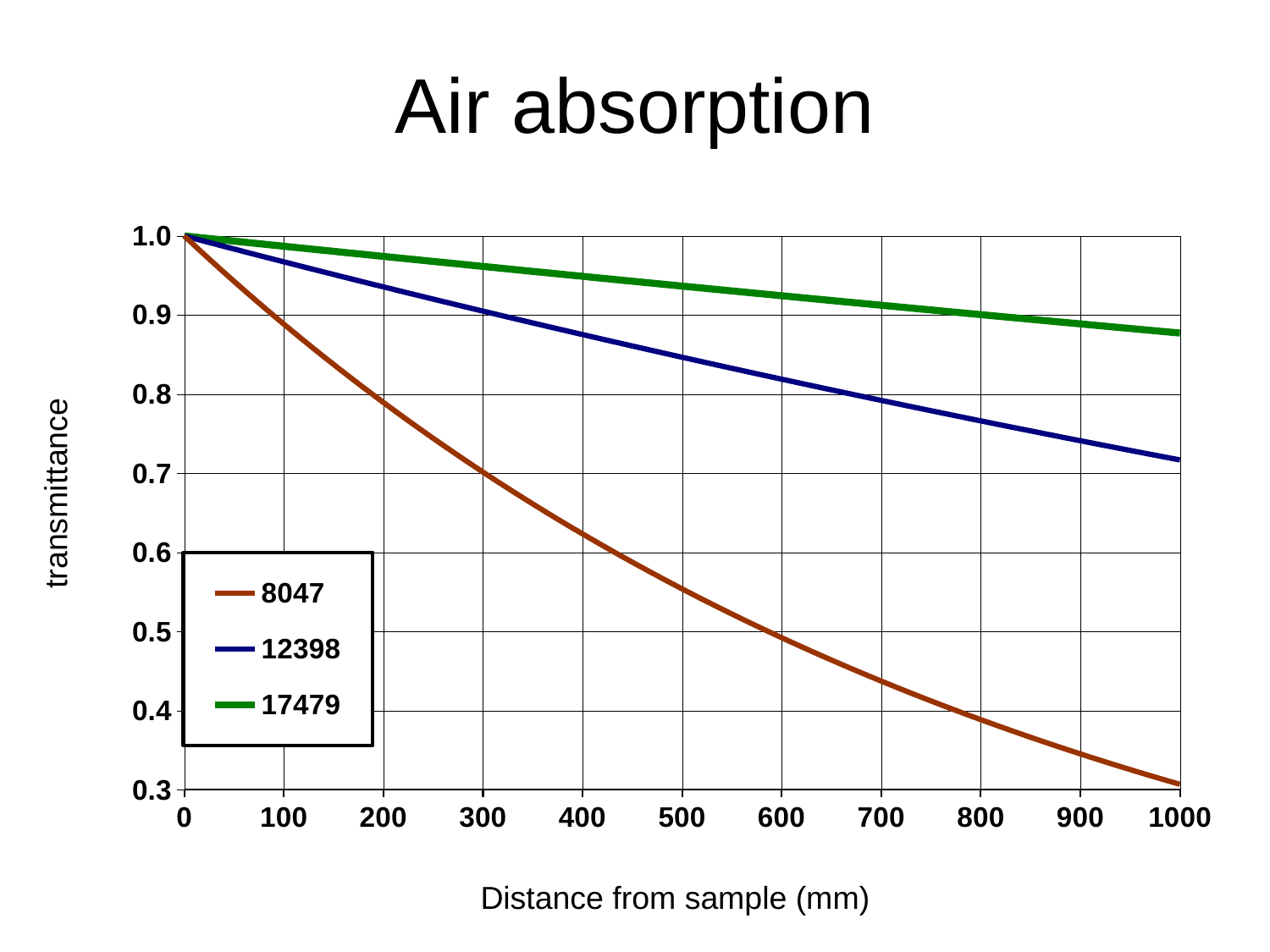
Which series has the highest transmittance at 1000 mm? 17479 Is the transmittance for series 17479 at 1000 mm greater or less than 0.9? less What is the label of the y axis? transmittance What kind of chart is shown on the slide? line chart Is the transmittance for series 8047 at 500 mm greater or less than 0.6? less Does the transmittance for series 8047 rise or fall as distance from sample increases? fall Is the transmittance for series 12398 at 1000 mm greater or less than 0.7? greater How many series does the legend list? 3 Which series has the lowest transmittance at 1000 mm? 8047 What is the title of the chart? Air absorption At 600 mm, which series has the larger transmittance, 12398 or 8047? 12398